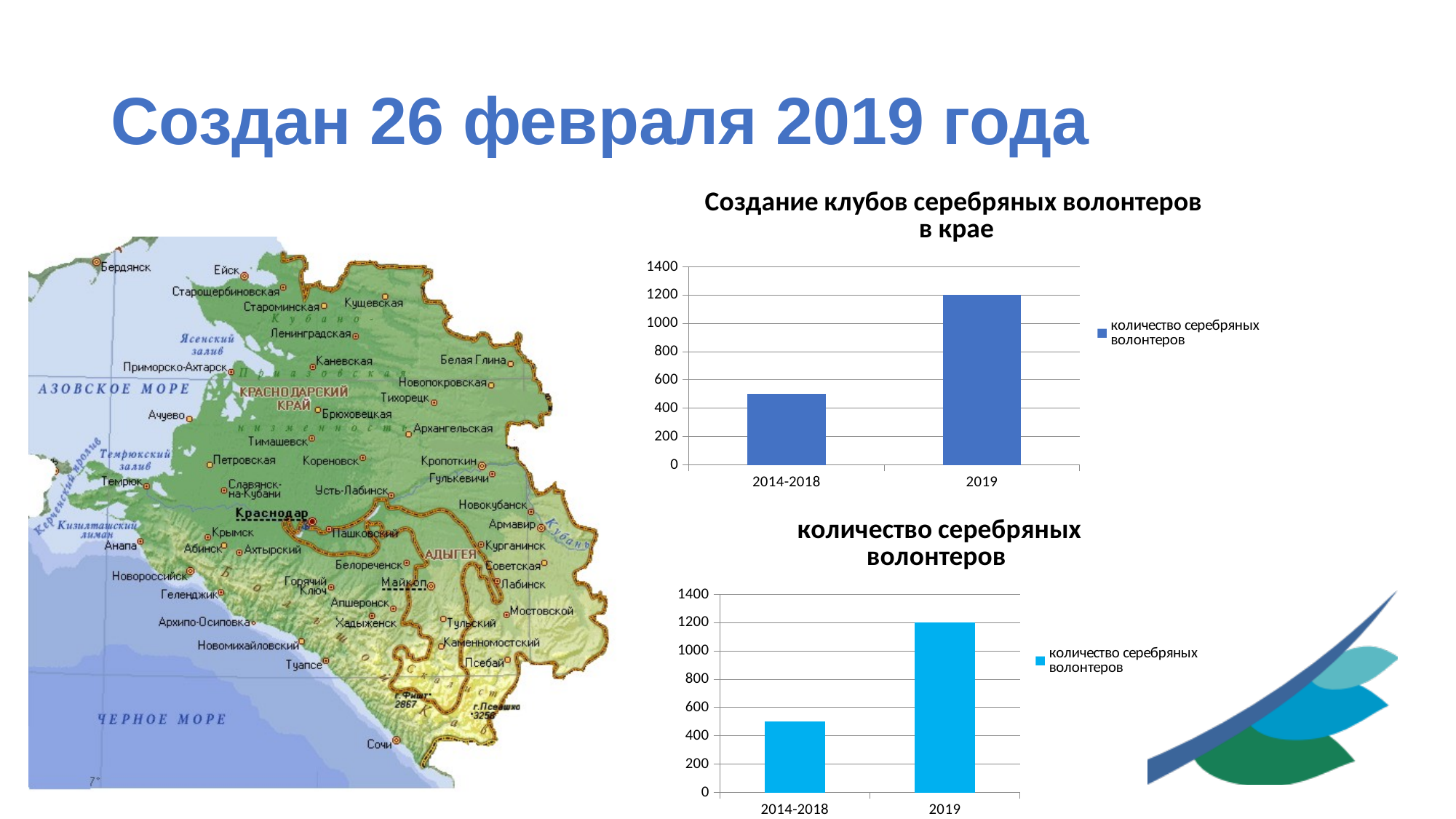
In the bottom chart titled 'количество серебряных волонтеров', is the value for 2014-2018 greater or less than 600? less In the top chart titled 'Создание клубов серебряных волонтеров в крае', how many categories are shown on the x axis? 2 In the bottom chart titled 'количество серебряных волонтеров', is the value for 2019 greater or less than 1000? greater In the top chart titled 'Создание клубов серебряных волонтеров в крае', is the value for 2014-2018 greater or less than 600? less In the top chart titled 'Создание клубов серебряных волонтеров в крае', what type of chart is it? bar chart In the bottom chart titled 'количество серебряных волонтеров', how many series does the legend list? 1 In the top chart titled 'Создание клубов серебряных волонтеров в крае', which category has the lowest value? 2014-2018 In the top chart titled 'Создание клубов серебряных волонтеров в крае', which category has the highest value? 2019 In the bottom chart titled 'количество серебряных волонтеров', which of the two categories has the larger value, 2014-2018 or 2019? 2019 In the bottom chart titled 'количество серебряных волонтеров', do the values rise or fall from 2014-2018 to 2019? rise